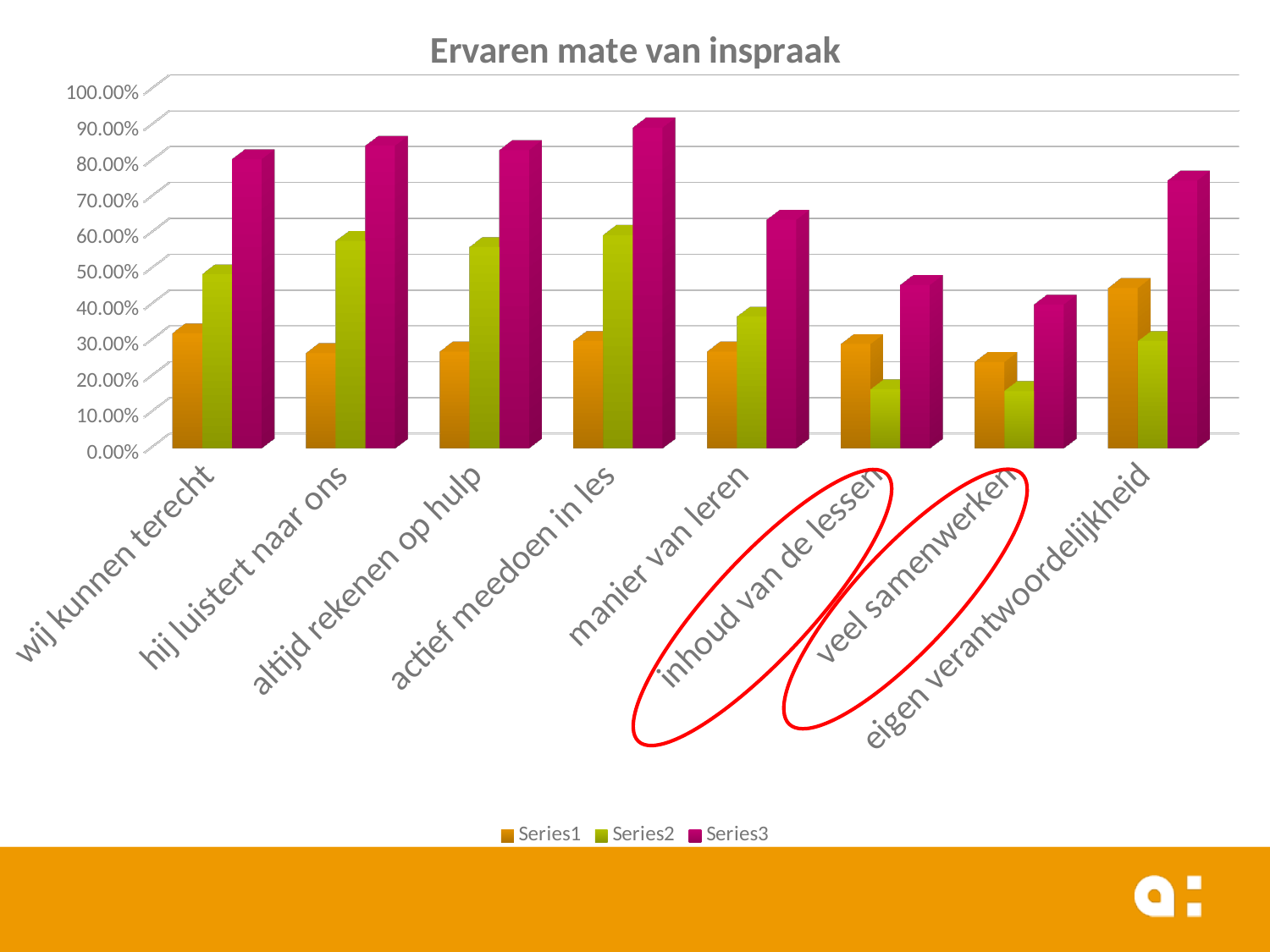
Is the Series3 value for actief meedoen in les greater or less than 80.00%? greater How many categories are shown on the x axis of the chart? 8 Which category has the highest Series3 value? actief meedoen in les Which category has the highest Series1 value? eigen verantwoordelijkheid Which category has the lowest Series3 value? veel samenwerken Which is larger: the Series3 value for wij kunnen terecht or the Series3 value for manier van leren? wij kunnen terecht Is the Series2 value for inhoud van de lessen greater or less than 20.00%? less Which two categories on the x axis are circled in red? inhoud van de lessen and veel samenwerken What type of chart is shown on the slide? bar chart How many series does the legend list? 3 Is the Series3 value for veel samenwerken greater or less than 50.00%? less What is the title of the chart? Ervaren mate van inspraak